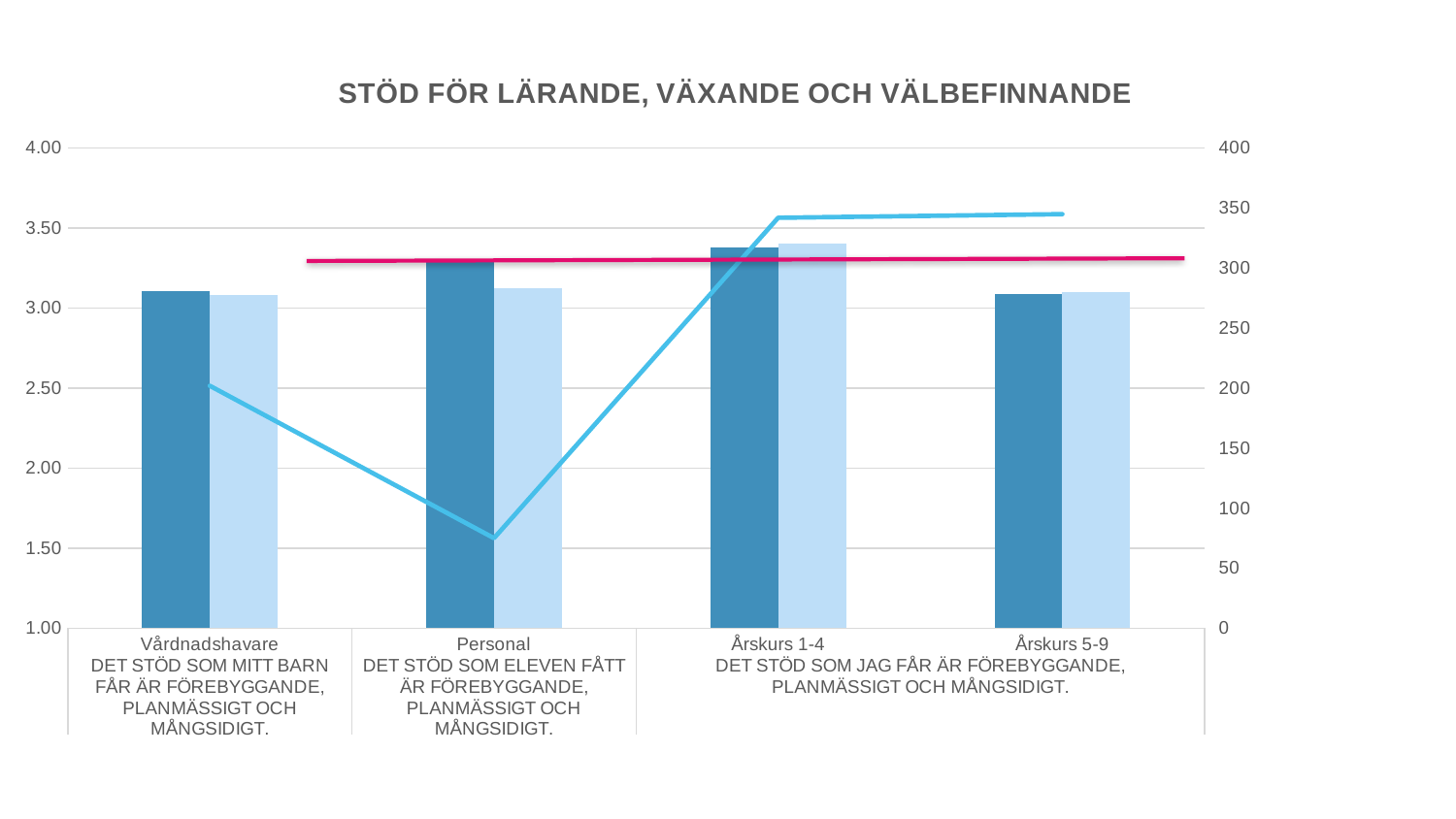
What is the title of the chart? STÖD FÖR LÄRANDE, VÄXANDE OCH VÄLBEFINNANDE Is the light blue line value for Personal larger or smaller than its value for Årskurs 1-4? smaller Is the light blue line value for Årskurs 5-9 greater or less than 300 on the right axis? greater What is the maximum value shown on the right-hand axis? 400 How many categories are shown along the x axis? 4 Is the light blue line value for Personal greater or less than 100 on the right axis? less Which category has the highest dark blue bar? Årskurs 1-4 Is the light blue line value for Årskurs 1-4 greater or less than 300 on the right axis? greater Does the light blue line rise or fall between Personal and Årskurs 1-4? rise What kind of chart is shown on the slide? A combined bar and line chart Which category has the highest light blue bar? Årskurs 1-4